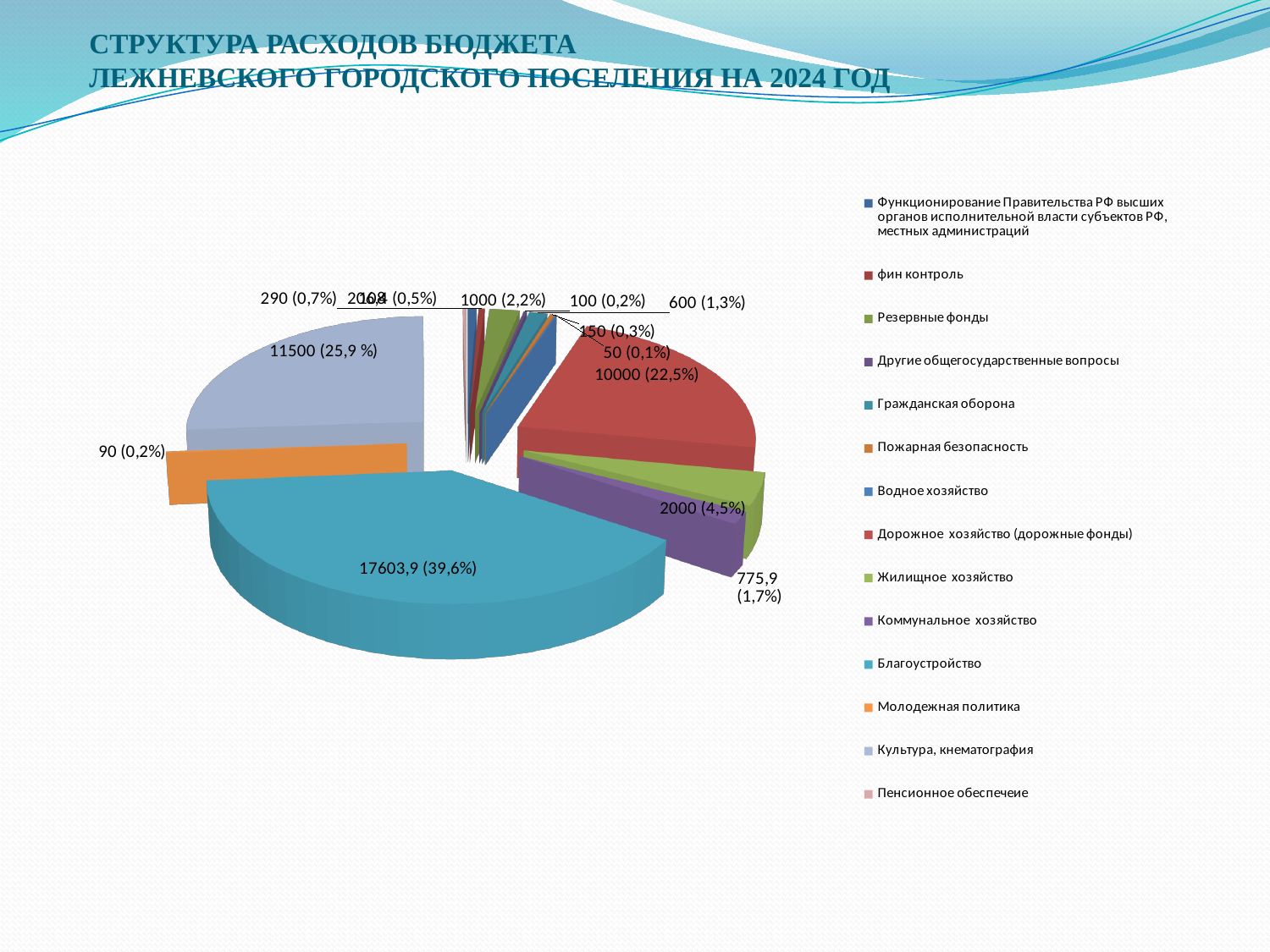
Which legend category corresponds to the largest slice (39,6%)? Благоустройство What is the difference between the Культура, кнематография value (11500) and the Дорожное хозяйство value (10000)? 1500 What kind of chart is shown on the slide? Pie chart What share of the pie does the Благоустройство slice represent? 39,6% What is the value shown for the largest slice of the pie? 17603,9 (39,6%) What value is shown for the Коммунальное хозяйство slice? 775,9 (1,7%) What is the title of the slide containing the chart? СТРУКТУРА РАСХОДОВ БЮДЖЕТА ЛЕЖНЕВСКОГО ГОРОДСКОГО ПОСЕЛЕНИЯ НА 2024 ГОД Which is larger: the Культура, кнематография slice or the Дорожное хозяйство slice? Культура, кнематография What value is shown for the Дорожное хозяйство (дорожные фонды) slice? 10000 (22,5%) How many entries does the legend list? 14 What value is shown for the Жилищное хозяйство slice? 2000 (4,5%) What value is shown for the Культура, кнематография slice? 11500 (25,9 %)